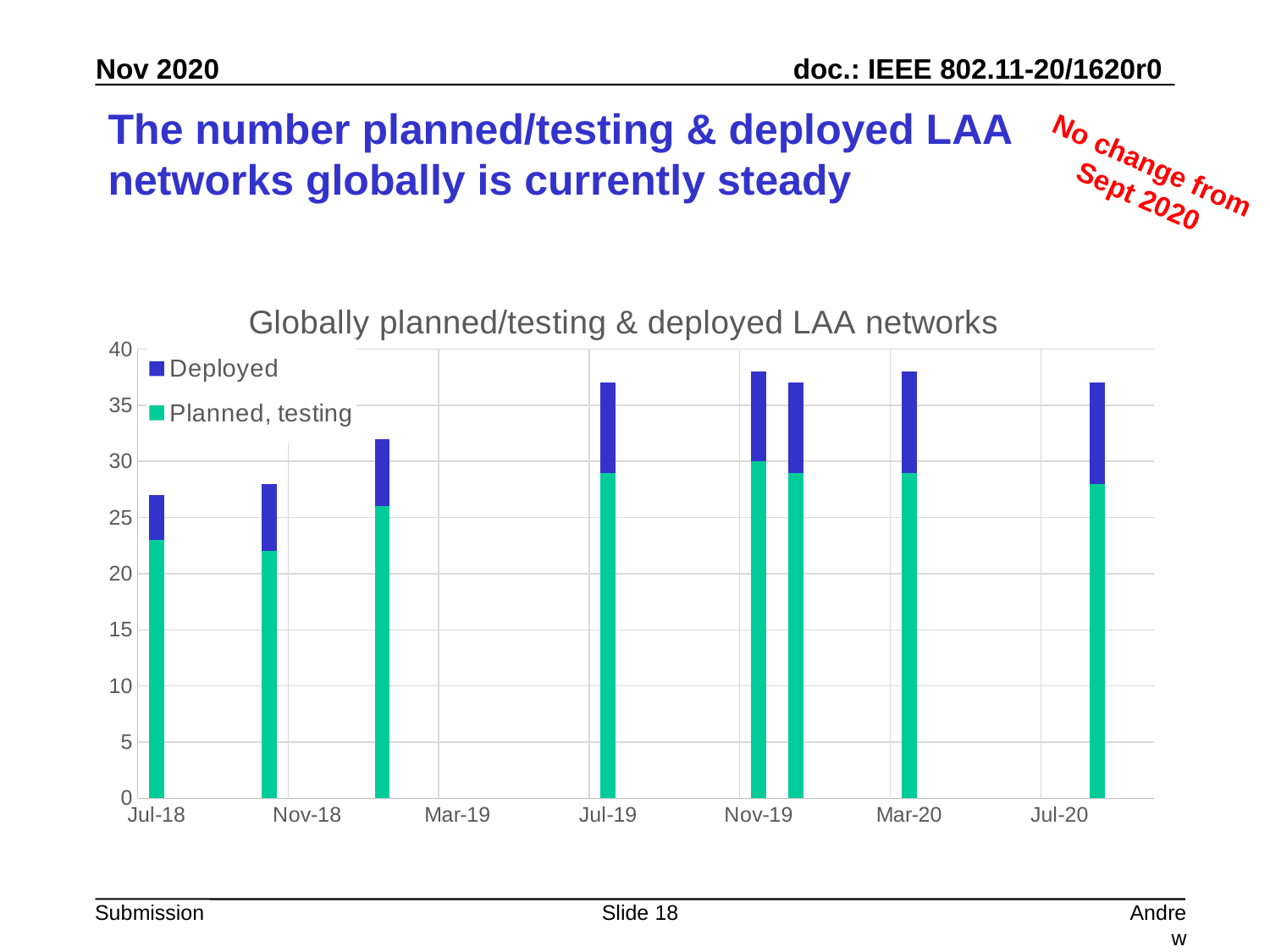
How many series does the chart legend list? 2 Is the total height of the Jul-19 bar greater or less than 35? greater Is the total height of the Jul-20 bar greater or less than 35? greater Which series is shown in green? Planned, testing How many bars are plotted in the chart? 8 Do the total bar heights generally rise or fall from Jul-18 to Jul-20? rise Is the total height of the Nov-18 bar greater or less than 30? less What kind of chart is shown on the slide? Stacked bar chart What is the title of the chart? Globally planned/testing & deployed LAA networks Which bar has a larger total, Jul-18 or Jul-19? Jul-19